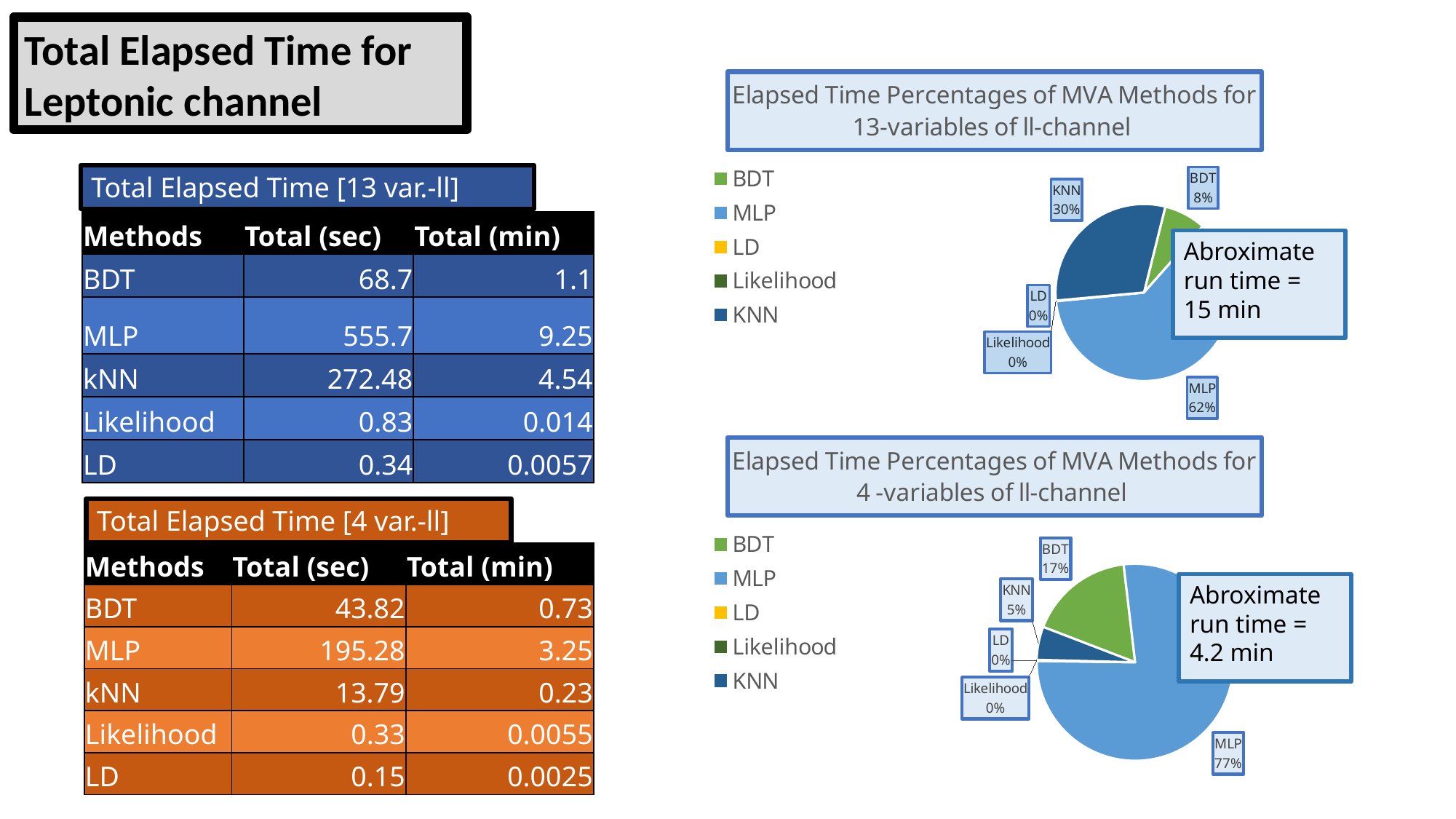
What kind of chart is the chart titled 'Elapsed Time Percentages of MVA Methods for 4 -variables of ll-channel'? Pie chart In the chart titled 'Elapsed Time Percentages of MVA Methods for 4 -variables of ll-channel', what percentage does BDT account for? 17% In the chart titled 'Elapsed Time Percentages of MVA Methods for 13-variables of ll-channel', what colour represents MLP in the legend? Light blue In the chart titled 'Elapsed Time Percentages of MVA Methods for 13-variables of ll-channel', which method has the largest share? MLP In the chart titled 'Elapsed Time Percentages of MVA Methods for 13-variables of ll-channel', what percentage does KNN account for? 30% In the chart titled 'Elapsed Time Percentages of MVA Methods for 13-variables of ll-channel', what is the difference in percentage points between MLP and KNN? 32 In the chart titled 'Elapsed Time Percentages of MVA Methods for 13-variables of ll-channel', how many entries does the legend list? 5 In the chart titled 'Elapsed Time Percentages of MVA Methods for 13-variables of ll-channel', what percentage does MLP account for? 62% In the chart titled 'Elapsed Time Percentages of MVA Methods for 4 -variables of ll-channel', which is larger, the share for BDT or the share for KNN? BDT In the chart titled 'Elapsed Time Percentages of MVA Methods for 4 -variables of ll-channel', what approximate run time is stated in the callout box? 4.2 min In the chart titled 'Elapsed Time Percentages of MVA Methods for 4 -variables of ll-channel', what percentage does KNN account for? 5% In the chart titled 'Elapsed Time Percentages of MVA Methods for 4 -variables of ll-channel', what is the difference in percentage points between MLP and BDT? 60